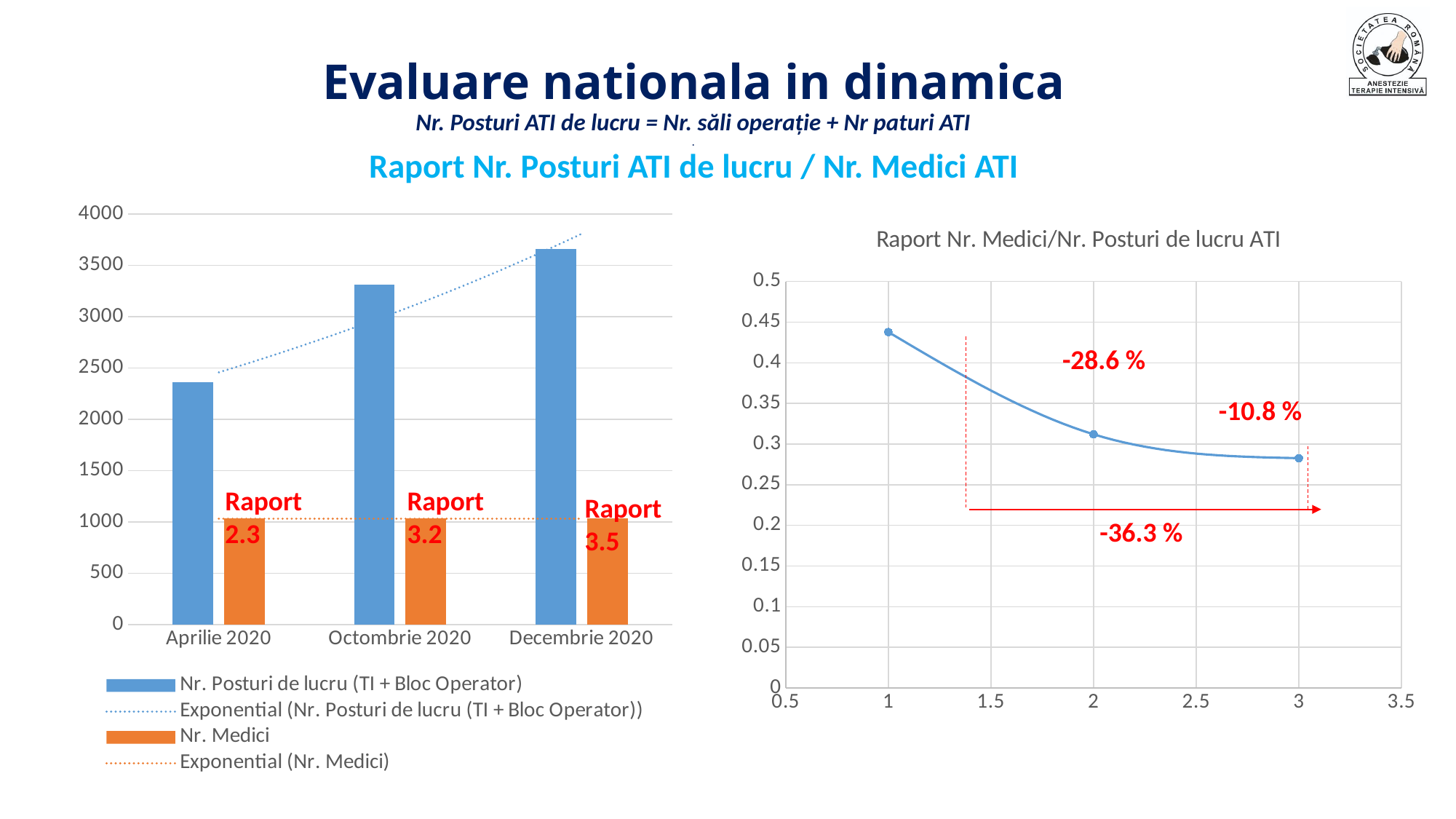
On the left chart, is the Nr. Posturi de lucru (TI + Bloc Operator) value for Decembrie 2020 greater or less than 3500? greater On the right chart, do the plotted values rise or fall from left to right along the x axis? fall On the left chart, in which period is the Nr. Posturi de lucru (TI + Bloc Operator) bar highest? Decembrie 2020 On the left chart, is the Nr. Posturi de lucru (TI + Bloc Operator) value for Aprilie 2020 greater or less than 2000? greater On the left chart, what Raport value is printed for Decembrie 2020? 3.5 On the left chart, what Raport value is printed for Octombrie 2020? 3.2 On the left chart, how many time periods are shown on the x axis? 3 On the left chart, what kind of chart is used to show Nr. Posturi de lucru and Nr. Medici? bar chart On the right chart, is the value at x = 1 greater or less than 0.4? greater On the left chart, in which period is the Nr. Posturi de lucru (TI + Bloc Operator) bar lowest? Aprilie 2020 On the left chart, how many entries does the legend list? 4 What is the title of the right chart? Raport Nr. Medici/Nr. Posturi de lucru ATI